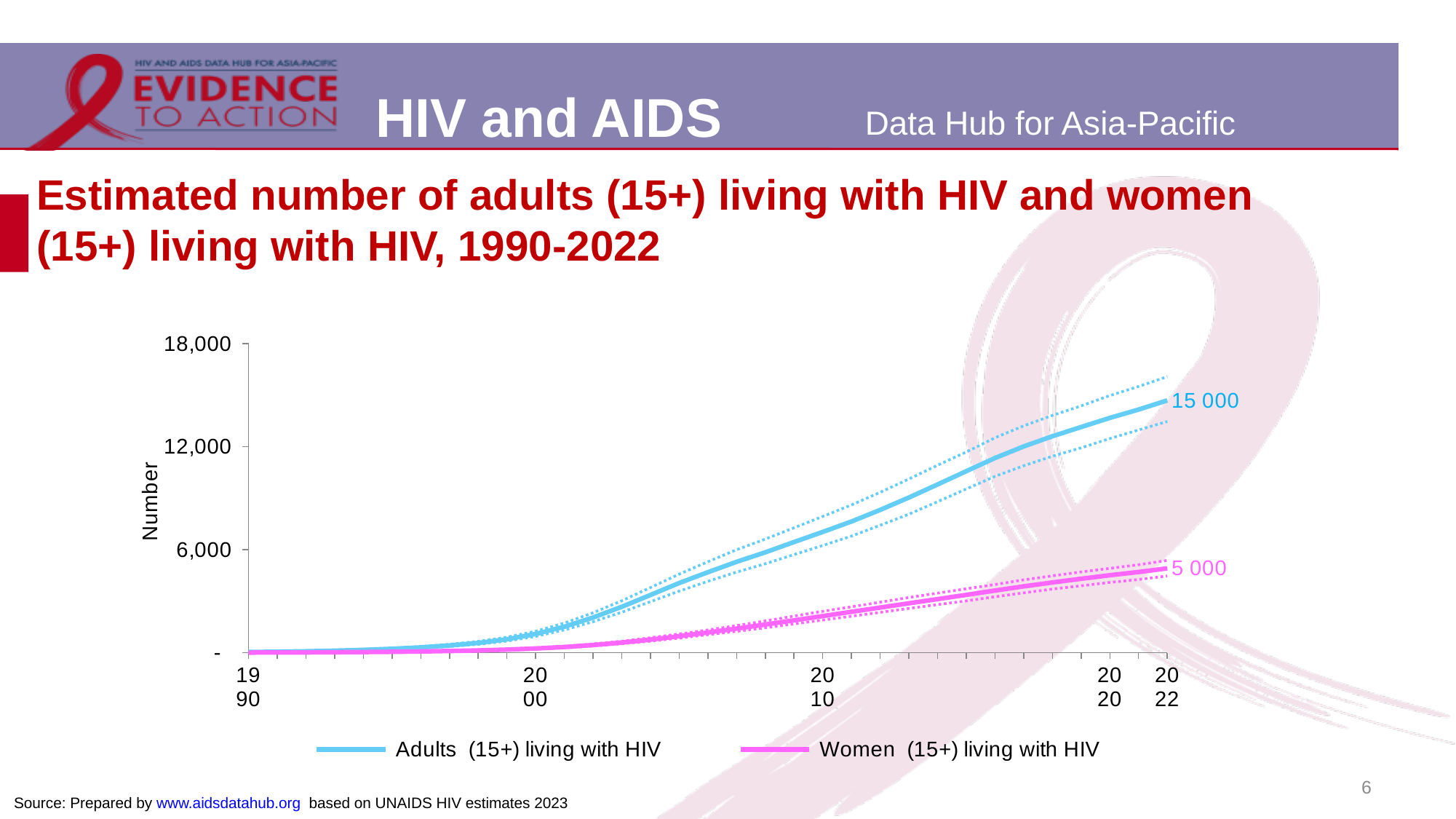
What is the difference between the 2022 values for adults (15+) living with HIV and women (15+) living with HIV? 10 000 Do the values for adults (15+) living with HIV rise or fall from 1990 to 2022? Rise What is the estimated number of women (15+) living with HIV in 2022? 5 000 What kind of chart is shown on the slide? Line chart Is the value for adults (15+) living with HIV in 2010 greater or less than 6,000? greater How many series does the legend list? 2 Is the value for women (15+) living with HIV in 2010 greater or less than 6,000? less What is the label on the vertical axis of the chart? Number In 2022, which series has the larger value: adults (15+) living with HIV or women (15+) living with HIV? Adults (15+) living with HIV What colour is the line for women (15+) living with HIV? Pink What is the estimated number of adults (15+) living with HIV in 2022? 15 000 Is the value for adults (15+) living with HIV in 2000 greater or less than 6,000? less